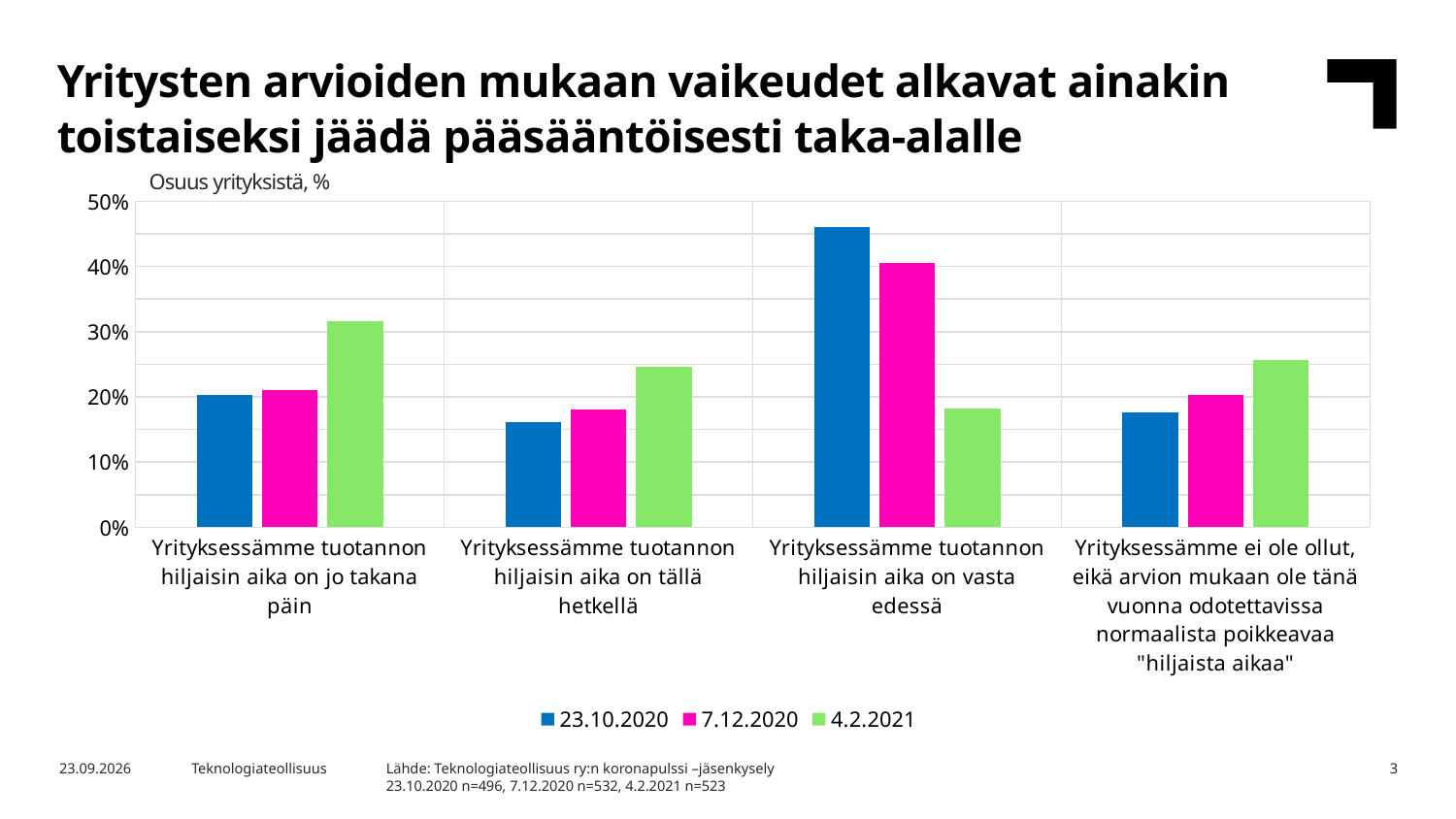
Across the three survey dates in order (23.10.2020, 7.12.2020, 4.2.2021), does the value for 'Yrityksessämme tuotannon hiljaisin aika on vasta edessä' rise or fall? fall Is the 4.2.2021 value for 'Yrityksessämme tuotannon hiljaisin aika on vasta edessä' greater or less than 20%? less What is the label shown above the y axis of the chart? Osuus yrityksistä, % What kind of chart is shown on the slide? bar chart Is the 4.2.2021 value for 'Yrityksessämme tuotannon hiljaisin aika on jo takana päin' greater or less than 30%? greater For 'Yrityksessämme tuotannon hiljaisin aika on jo takana päin', which series has the larger value: 23.10.2020 or 4.2.2021? 4.2.2021 How many series does the legend list? 3 Which category has the highest value for the 23.10.2020 series? Yrityksessämme tuotannon hiljaisin aika on vasta edessä Which category has the lowest value for the 4.2.2021 series? Yrityksessämme tuotannon hiljaisin aika on vasta edessä How many categories are shown on the x axis? 4 For 'Yrityksessämme tuotannon hiljaisin aika on vasta edessä', which series has the larger value: 23.10.2020 or 4.2.2021? 23.10.2020 Is the 23.10.2020 value for 'Yrityksessämme tuotannon hiljaisin aika on vasta edessä' greater or less than 40%? greater